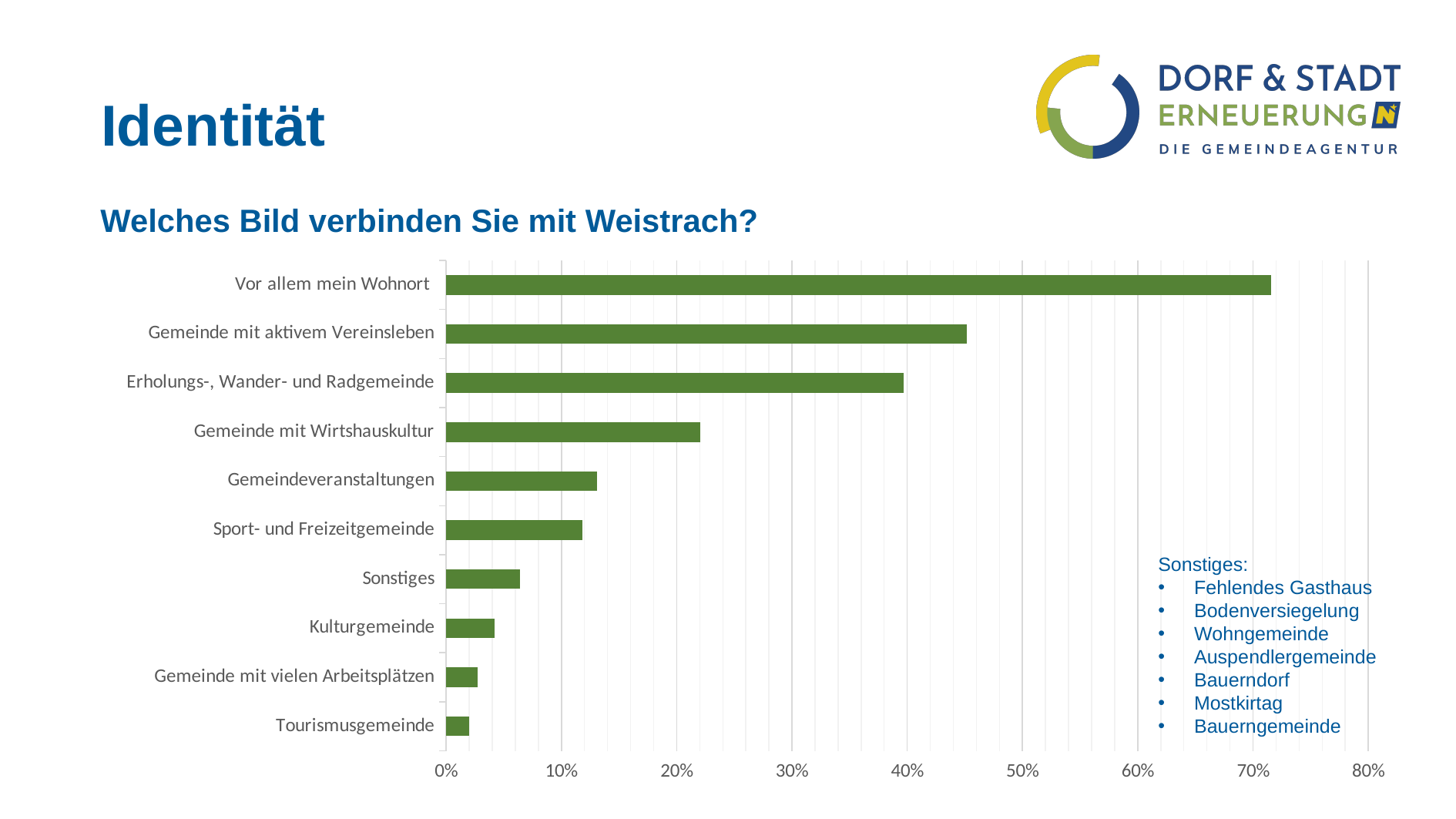
What kind of chart is shown on the slide? bar chart What question is the chart titled with? Welches Bild verbinden Sie mit Weistrach? Which is larger: the value for Gemeinde mit aktivem Vereinsleben or the value for Erholungs-, Wander- und Radgemeinde? Gemeinde mit aktivem Vereinsleben Is the value for Gemeinde mit Wirtshauskultur greater or less than 30%? less Is the value for Sonstiges greater or less than 10%? less Is the value for Vor allem mein Wohnort greater or less than 60%? greater Which category has the lowest value in the chart? Tourismusgemeinde Which category has the highest value in the chart? Vor allem mein Wohnort Which is larger: the value for Gemeinde mit Wirtshauskultur or the value for Sport- und Freizeitgemeinde? Gemeinde mit Wirtshauskultur How many categories are plotted in the chart? 10